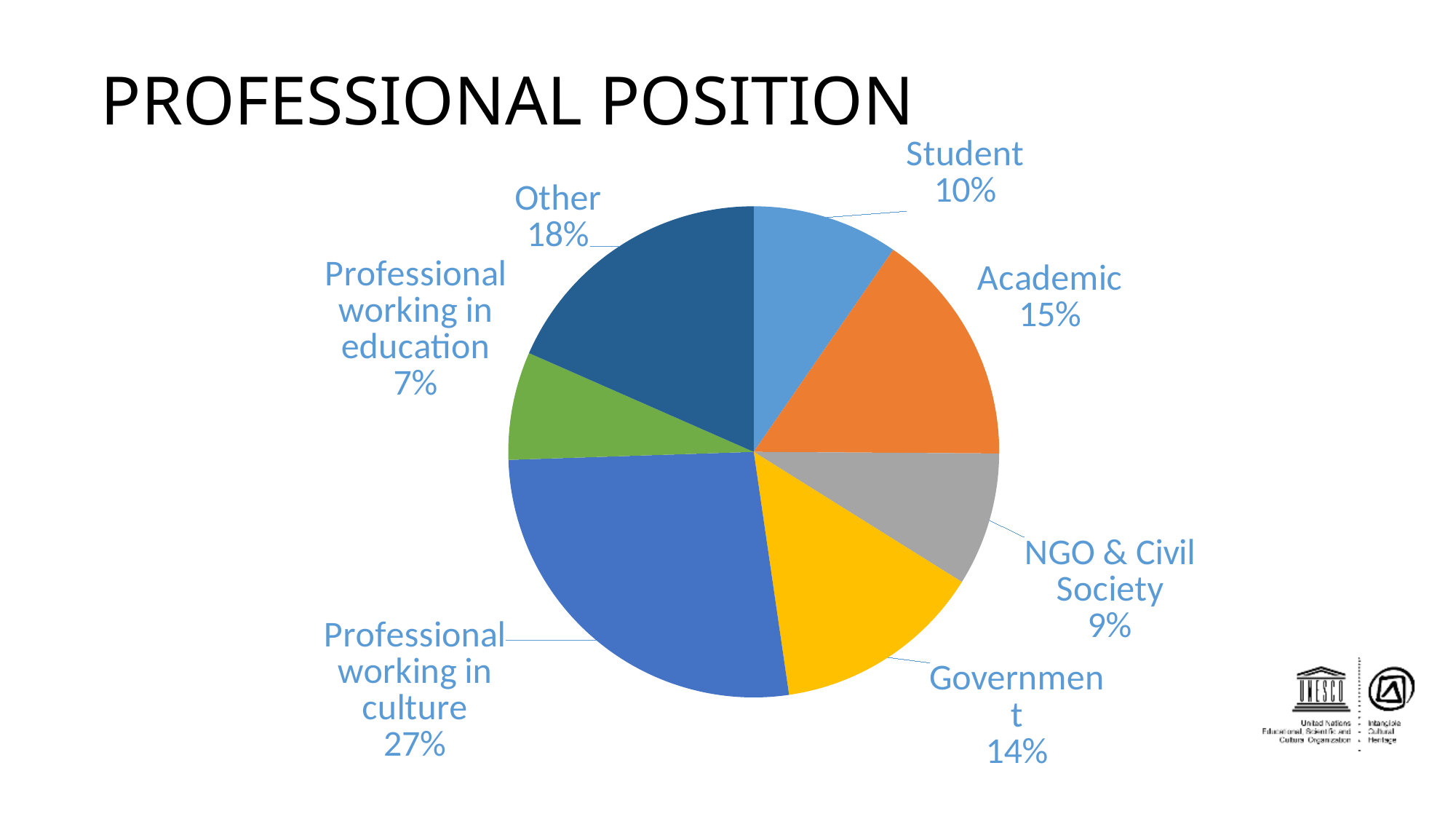
What percentage is shown for Academic? 15% Which is larger, Academic or Government? Academic What share of the pie does Professional working in culture represent? 27% Which category has the largest share of the pie? Professional working in culture What is the difference in percentage points between Other and Student? 8 What percentage is shown for NGO & Civil Society? 9% What percentage is shown for Government? 14% Which category has the smallest share of the pie? Professional working in education How many categories are shown in the pie chart? 7 What percentage is shown for Professional working in education? 7% What type of chart is shown on the slide? pie chart What share of the pie does Student represent? 10%